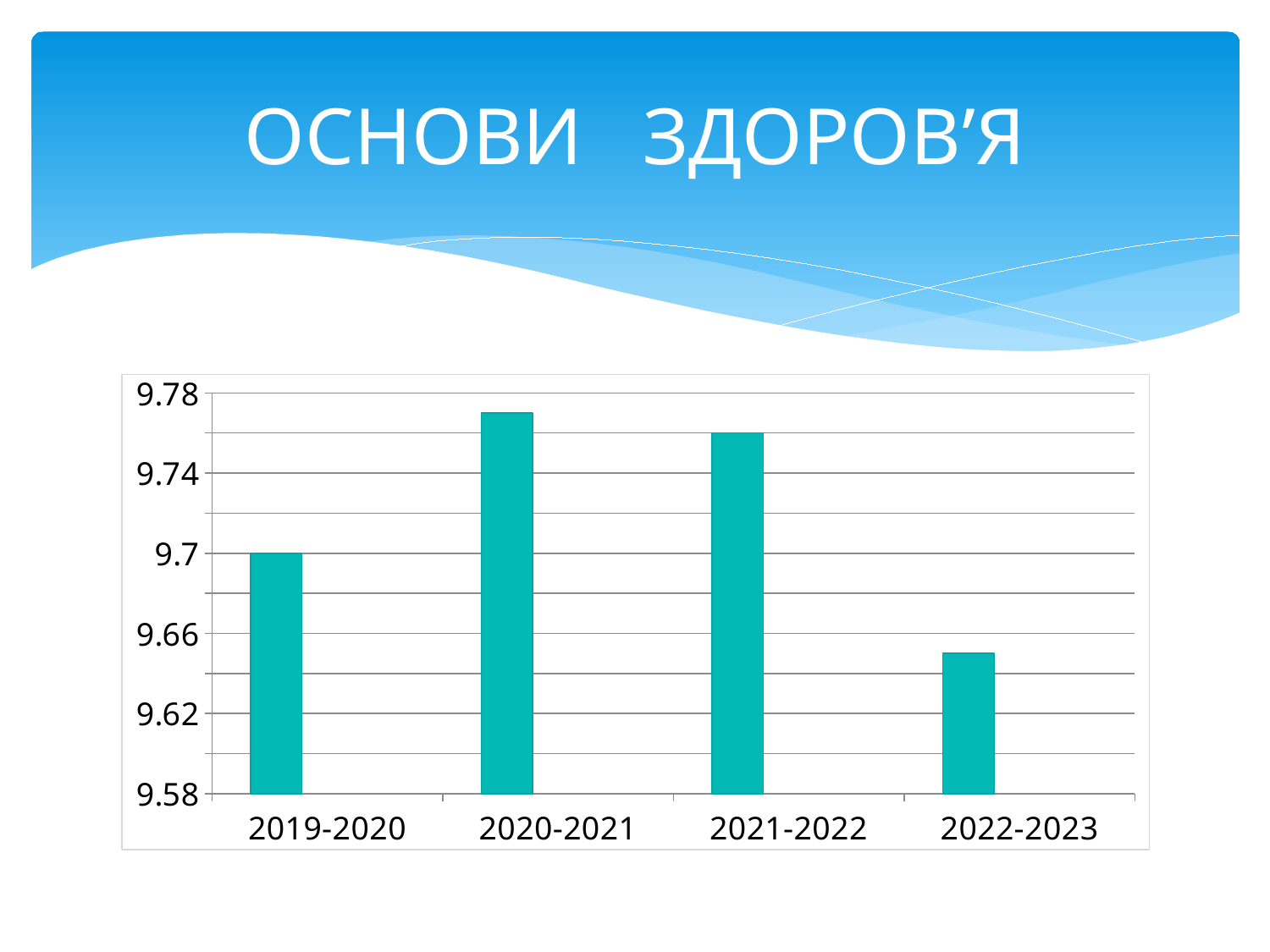
Is the value for 2022-2023 greater or less than 9.66? less Is the value for 2022-2023 greater or less than 9.62? greater What is the value for 2019-2020? 9.7 Which is larger, the value for 2020-2021 or the value for 2019-2020? 2020-2021 What is the title of the slide containing the chart? ОСНОВИ ЗДОРОВ’Я How many categories (school years) are shown on the x axis? 4 Is the value for 2020-2021 greater or less than 9.74? greater Which school year has the lowest value? 2022-2023 Which is larger, the value for 2019-2020 or the value for 2022-2023? 2019-2020 What kind of chart is shown on the slide? bar chart Do the values rise or fall from 2021-2022 to 2022-2023? fall